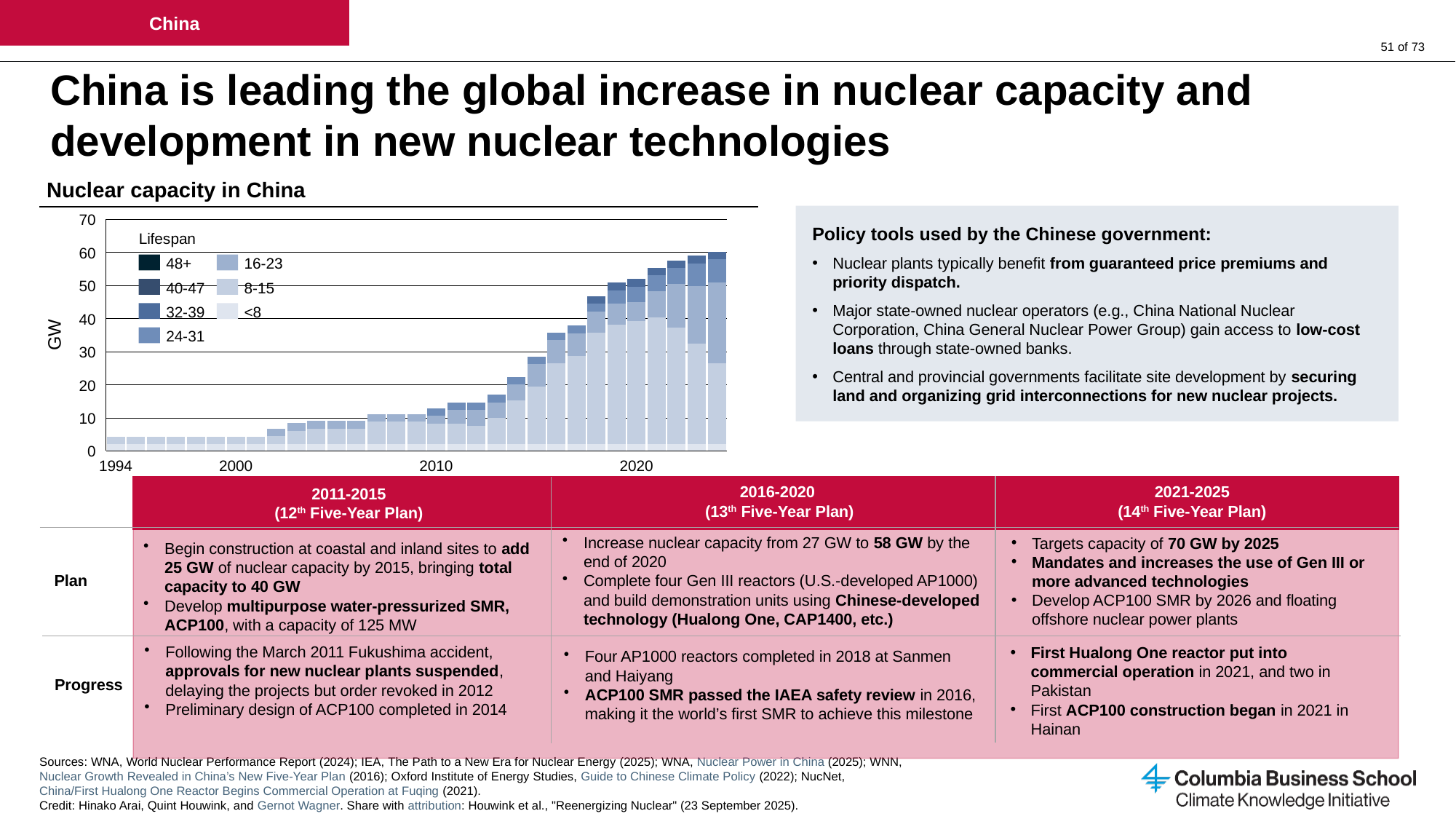
How many lifespan categories does the legend of the nuclear capacity chart list? 7 What unit is shown on the y-axis of the nuclear capacity chart? GW Does nuclear capacity in China rise or fall from 1994 to the most recent year shown? rise What is the highest value shown on the y-axis of the nuclear capacity chart? 70 Is the total nuclear capacity in China in 1994 greater or less than 10 GW? less Is the total nuclear capacity in China in 2020 greater or less than 40 GW? greater Is the total nuclear capacity in China in the last year shown greater or less than 50 GW? greater Which year has the higher total nuclear capacity in China, 2010 or 2020? 2020 What kind of chart is used to show nuclear capacity in China? stacked bar chart What is the title of the chart on the slide? Nuclear capacity in China